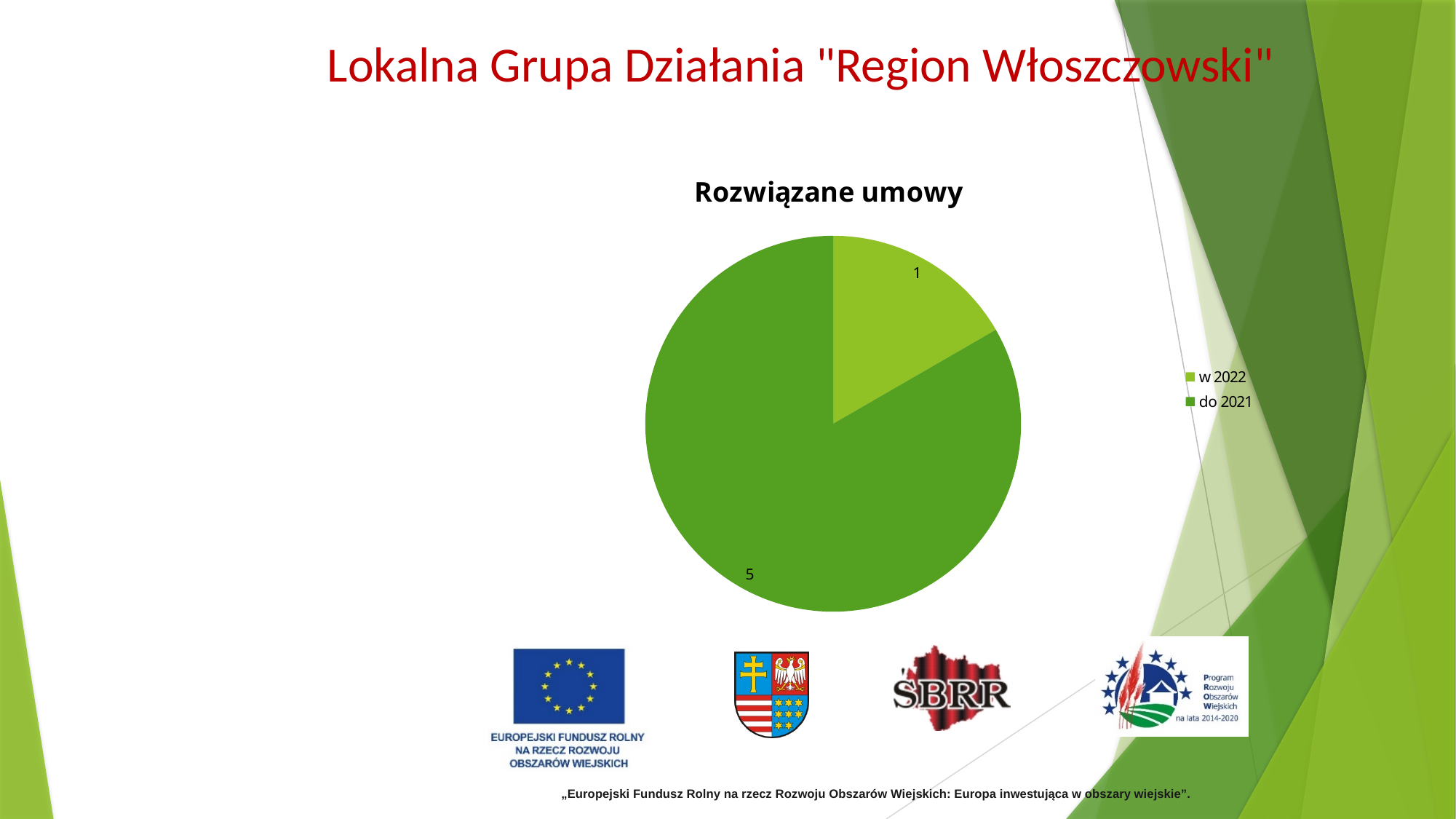
What kind of chart is shown on the slide? pie chart Which category has the largest slice? do 2021 What is the title of the chart? Rozwiązane umowy Which is larger, the value for "w 2022" or the value for "do 2021"? do 2021 What is the total of all slices in the pie chart? 6 What is the value for "w 2022"? 1 What is the difference between the values for "do 2021" and "w 2022"? 4 How many slices does the pie chart have? 2 Which category has the smallest slice? w 2022 How many entries does the legend list? 2 What share of the pie does "w 2022" represent? 1/6 What is the value for "do 2021"? 5